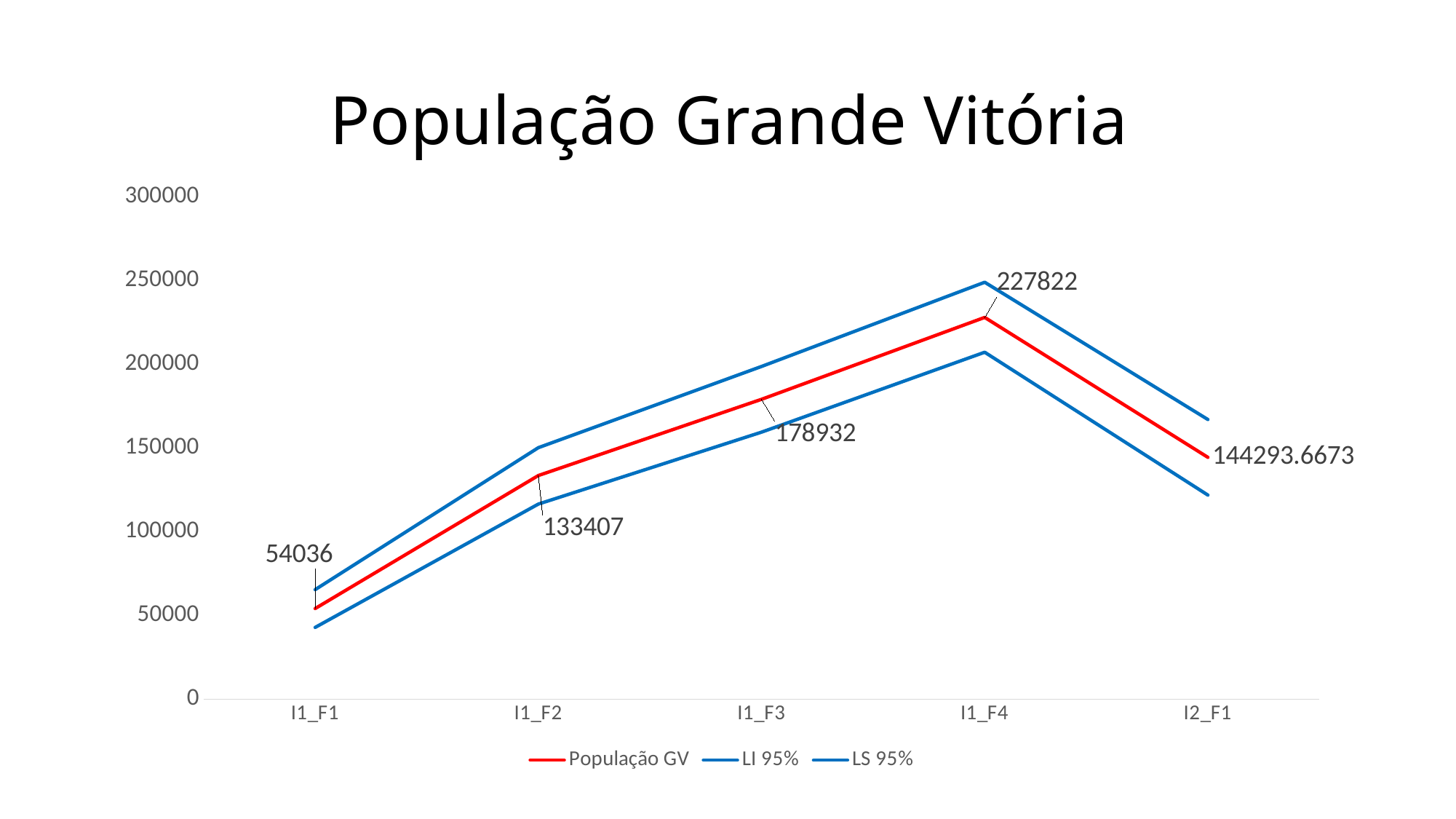
What is the value of População GV at I2_F1? 144293.6673 Is the LS 95% value at I1_F4 greater or less than 200000? greater What is the value of População GV at I1_F4? 227822 How many categories are shown on the x axis? 5 What is the difference between the População GV values at I1_F4 and I1_F3? 48890 What is the value of População GV at I1_F1? 54036 What is the title of the chart? População Grande Vitória How many series does the legend list? 3 What kind of chart is shown on the slide? line chart At which category is População GV lowest? I1_F1 Which is larger, the População GV value at I1_F2 or at I2_F1? I2_F1 At which category does População GV reach its highest value? I1_F4